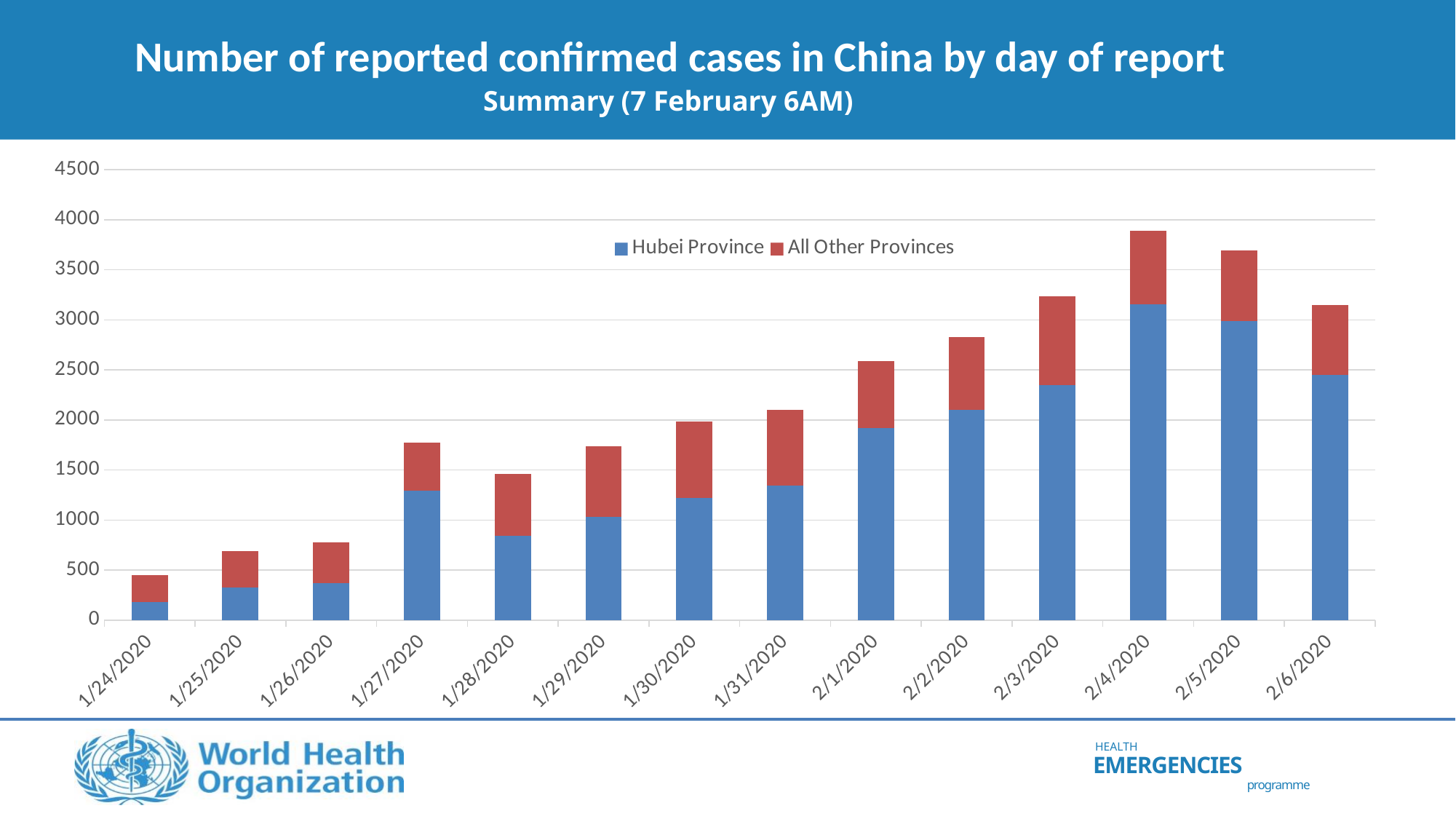
Which date has the lowest total number of reported confirmed cases? 1/24/2020 Is the Hubei Province value for 2/6/2020 greater or less than 2000? greater Which date has the highest total number of reported confirmed cases? 2/4/2020 Is the total value for 1/27/2020 greater or less than 1500? greater What kind of chart is shown on the slide? Stacked bar chart Is the total value for 2/4/2020 greater or less than 3500? greater Does the total number of reported cases rise or fall from 1/24/2020 to 2/4/2020? rise How many series does the legend list? 2 Which date has the larger total number of cases, 2/5/2020 or 2/6/2020? 2/5/2020 How many dates are shown along the x axis? 14 Which colour represents Hubei Province in the chart? Blue What is the title of the chart? Number of reported confirmed cases in China by day of report